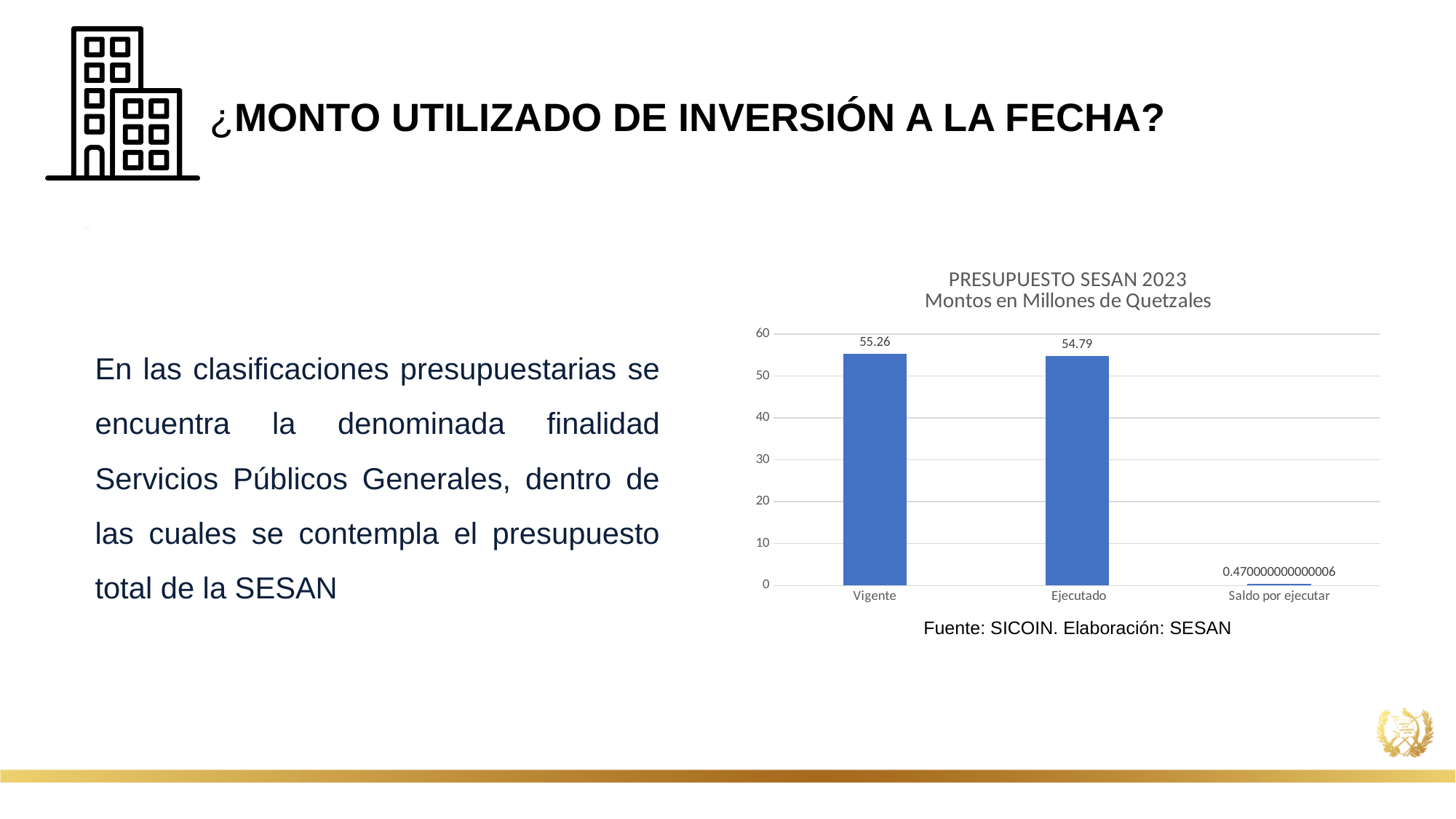
Which category has the highest value? Vigente What is the value for Ejecutado? 54.79 What is the value for Vigente? 55.26 Do the values rise or fall from left to right along the x axis? fall How many categories are shown on the x axis? 3 Which is larger, the value for Vigente or the value for Ejecutado? Vigente What is the value shown for Saldo por ejecutar? 0.470000000000006 Which category has the lowest value? Saldo por ejecutar What is the difference between the Vigente and Ejecutado values? 0.47 What kind of chart is shown on the slide? bar chart Is the value for Ejecutado greater or less than 50? greater What is the title of the chart? PRESUPUESTO SESAN 2023 Montos en Millones de Quetzales